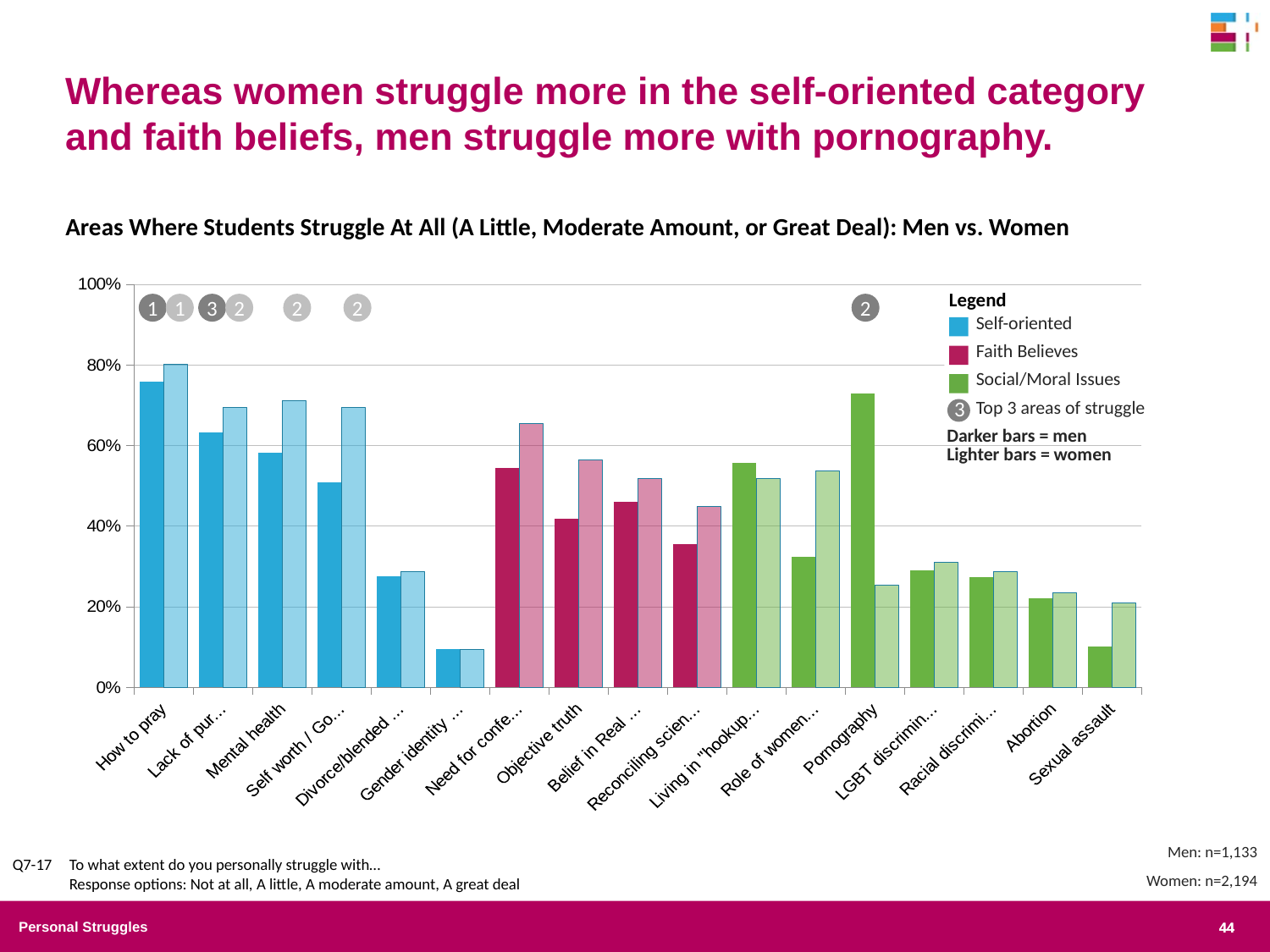
Which category has the highest bar for women (lighter bars)? How to pray Is the men's value for Pornography greater or less than 60%? greater Is the women's value for Pornography greater or less than 40%? less According to the chart's legend, do the darker bars represent men or women? Men For Mental health, is the men's bar or the women's bar larger? Women How many struggle areas (categories) are shown along the x axis of the chart? 17 For Sexual assault, is the men's bar or the women's bar larger? Women What kind of chart is shown on the slide? Bar chart For Pornography, is the men's bar or the women's bar larger? Men Is the men's value for Gender identity greater or less than 20%? less Which category has the lowest bar for women (lighter bars)? Gender identity According to the legend, which colour represents Social/Moral Issues? Green